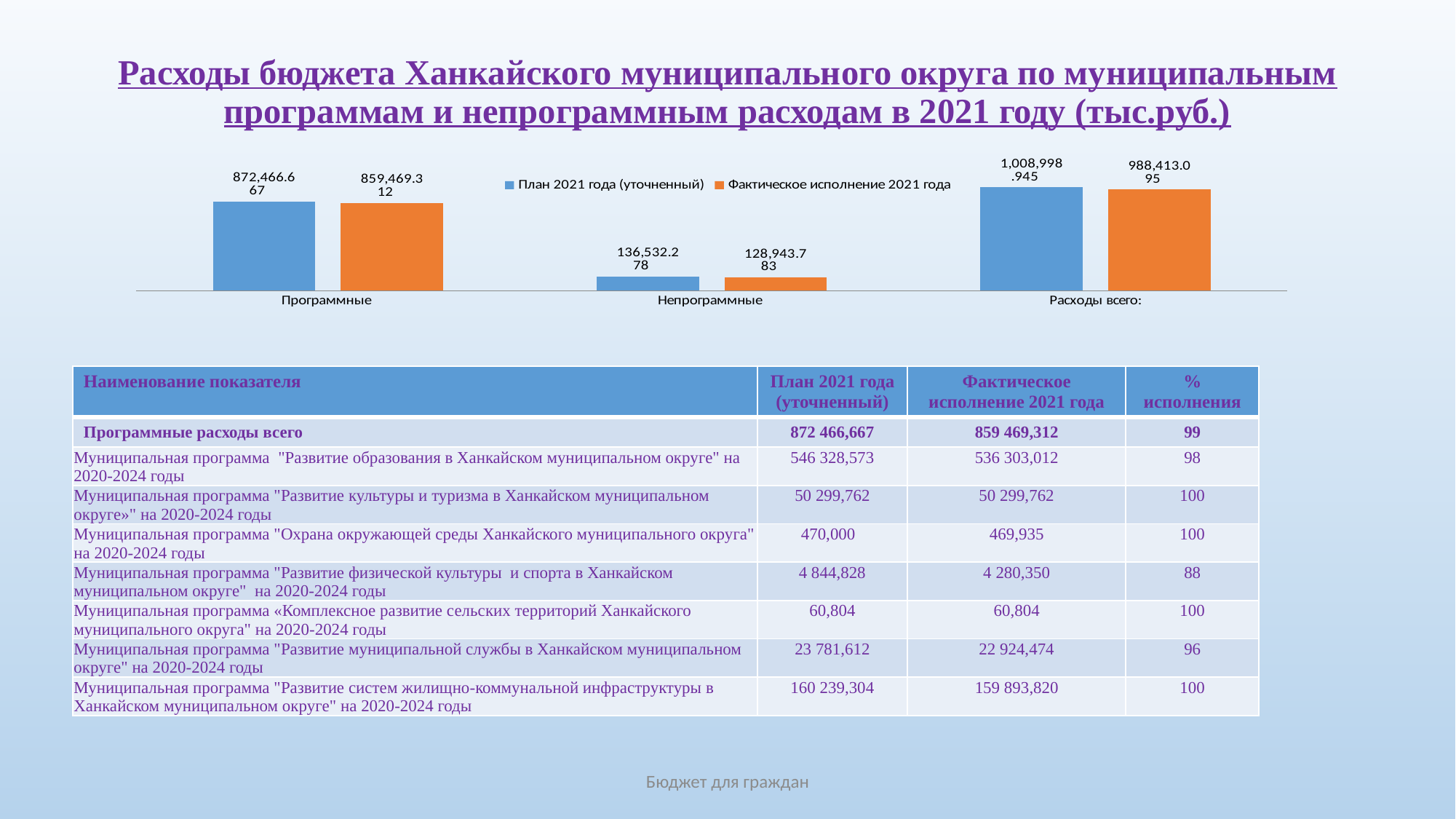
What is the value of the 'Фактическое исполнение 2021 года' bar for 'Расходы всего:'? 988,413.095 Which category has the highest value for 'План 2021 года (уточненный)'? Расходы всего: For 'Программные', which is larger: 'План 2021 года (уточненный)' or 'Фактическое исполнение 2021 года'? План 2021 года (уточненный) What is the difference between 'План 2021 года (уточненный)' and 'Фактическое исполнение 2021 года' for 'Расходы всего:'? 20,585.850 What is the value of the 'План 2021 года (уточненный)' bar for 'Расходы всего:'? 1,008,998.945 Which category has the lowest value for 'Фактическое исполнение 2021 года'? Непрограммные How many categories are shown on the x axis of the chart? 3 What type of chart is shown on the slide? Bar chart What is the value of the 'Фактическое исполнение 2021 года' bar for 'Непрограммные'? 128,943.783 What is the difference between 'План 2021 года (уточненный)' and 'Фактическое исполнение 2021 года' for 'Непрограммные'? 7,588.495 What is the value of the 'План 2021 года (уточненный)' bar for 'Программные'? 872,466.667 How many series does the chart legend list? 2